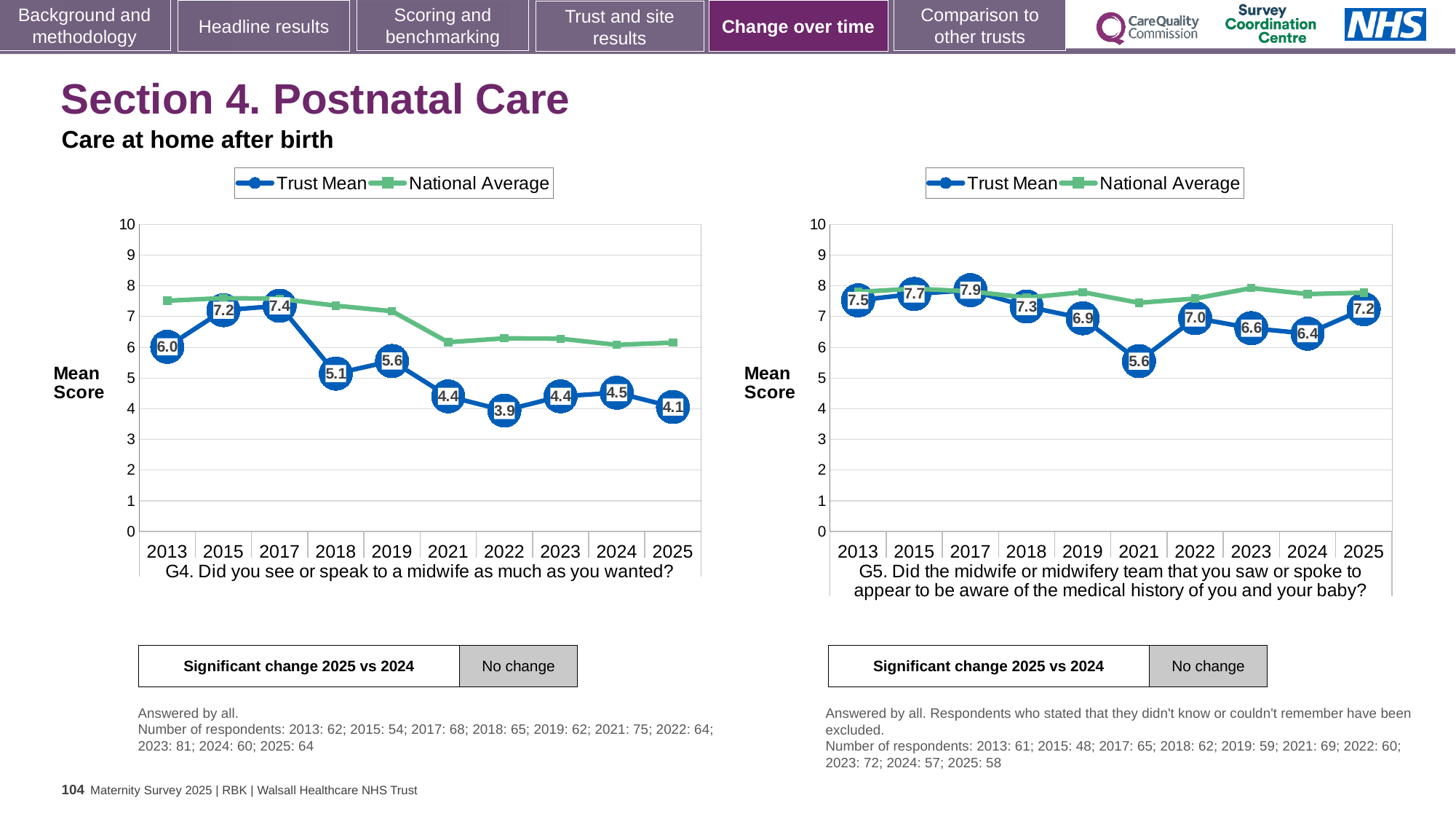
In the G4 chart (left), which year has the lowest Trust Mean score? 2022 In the G4 chart (left), what is the Trust Mean score for 2013? 6.0 How many series does the legend of the G5 chart (right) list? 2 In the G4 chart (left), is the National Average for 2025 greater or less than 5? greater How many years are plotted on the x axis of the G4 chart (left)? 10 In the G4 chart (left), which year has the highest Trust Mean score? 2017 In the G5 chart (right), what is the Trust Mean score for 2021? 5.6 In the G5 chart (right), which year has the highest Trust Mean score? 2017 In the G5 chart (right), which is larger, the Trust Mean for 2024 or for 2025? 2025 In the G4 chart (left), what is the difference between the Trust Mean scores for 2017 and 2018? 2.3 In the G4 chart (left), what is the Trust Mean score for 2025? 4.1 In the G5 chart (right), what is the difference between the Trust Mean scores for 2025 and 2024? 0.8